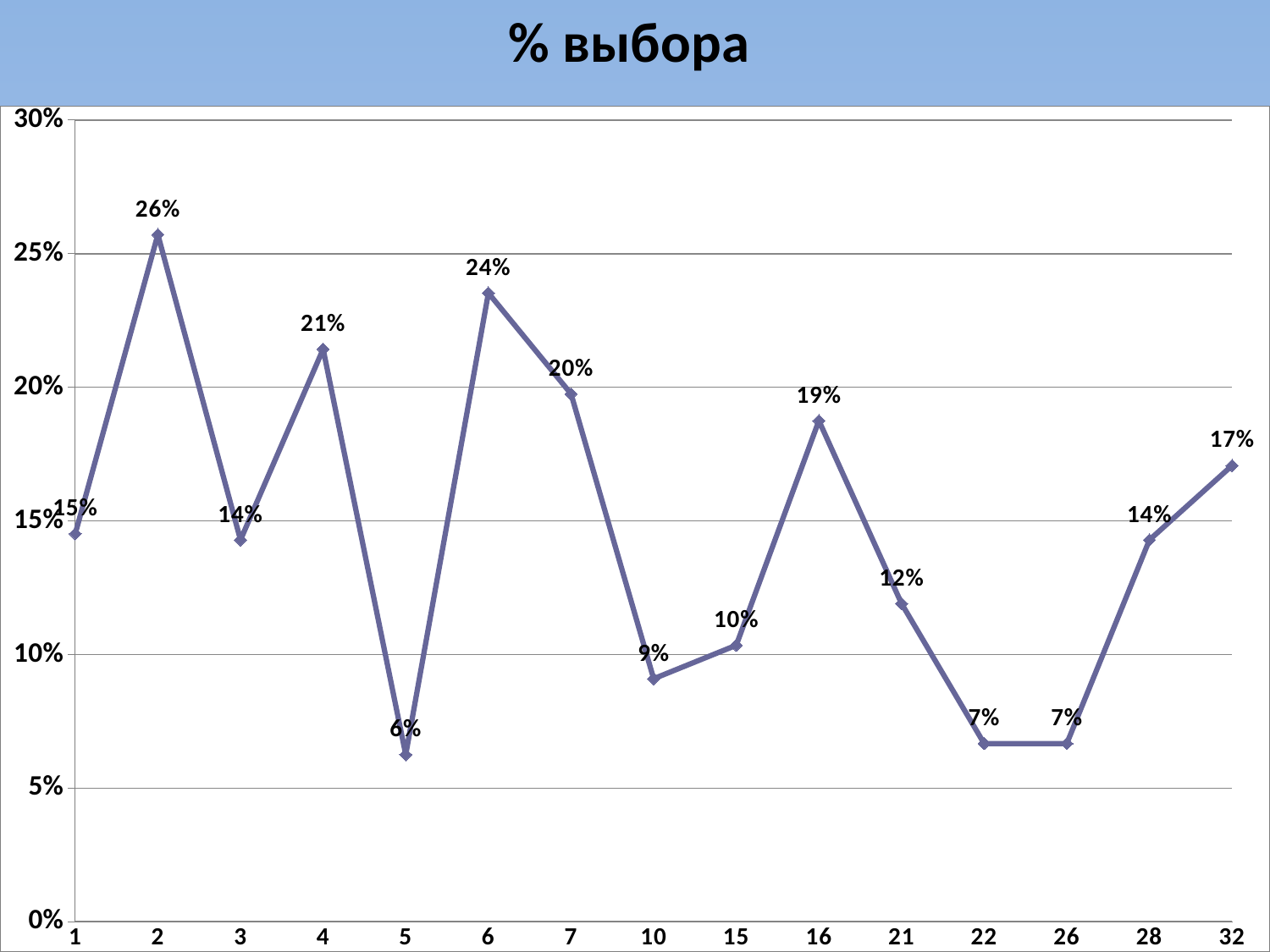
What is the difference between the values for category 2 and category 5? 20% What is the value for category 32? 17% Which category has the highest value? 2 Do the values rise or fall from category 22 to category 32? rise Which category has the lowest value? 5 What is the title of the chart? % выбора How many data points are plotted on the chart? 15 What is the value for category 2? 26% Which has a larger value, category 4 or category 6? 6 What type of chart is shown on the slide? line chart Is the value for category 21 greater or less than 15%? less What is the value for category 16? 19%